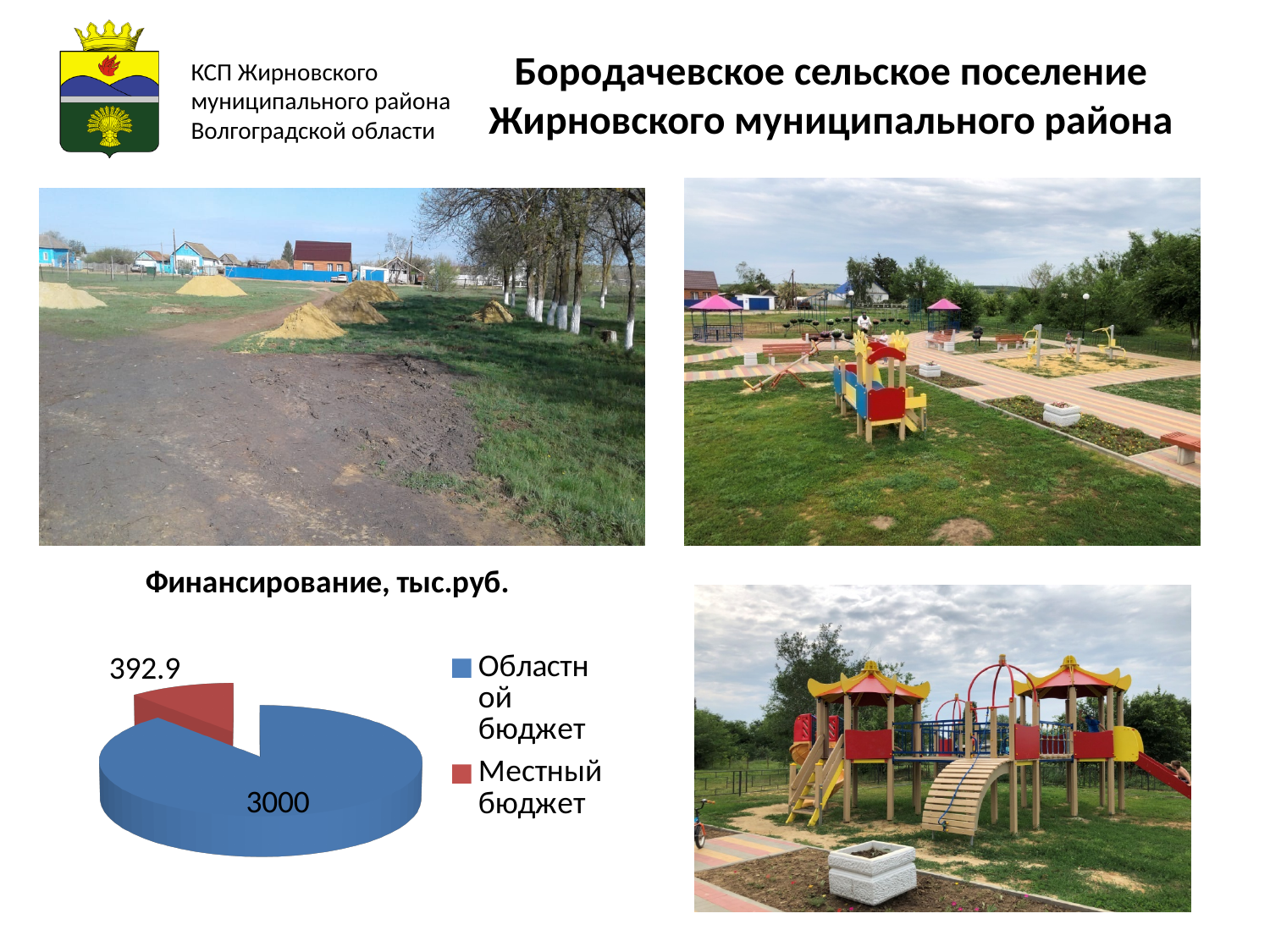
How many slices does the pie chart have? 2 Which is larger in the pie chart: Областной бюджет or Местный бюджет? Областной бюджет What share of the pie chart does Местный бюджет represent? 11.6% What is the difference between the Областной бюджет and Местный бюджет values in the pie chart? 2607.1 What type of chart is shown under the title "Финансирование, тыс.руб."? pie chart Which category has the smallest slice in the pie chart? Местный бюджет Which category has the largest slice in the pie chart? Областной бюджет What is the title of the pie chart? Финансирование, тыс.руб. What is the total of all slices in the pie chart? 3392.9 What is the value for Местный бюджет in the pie chart? 392.9 How many entries does the legend of the pie chart list? 2 What is the value for Областной бюджет in the pie chart? 3000